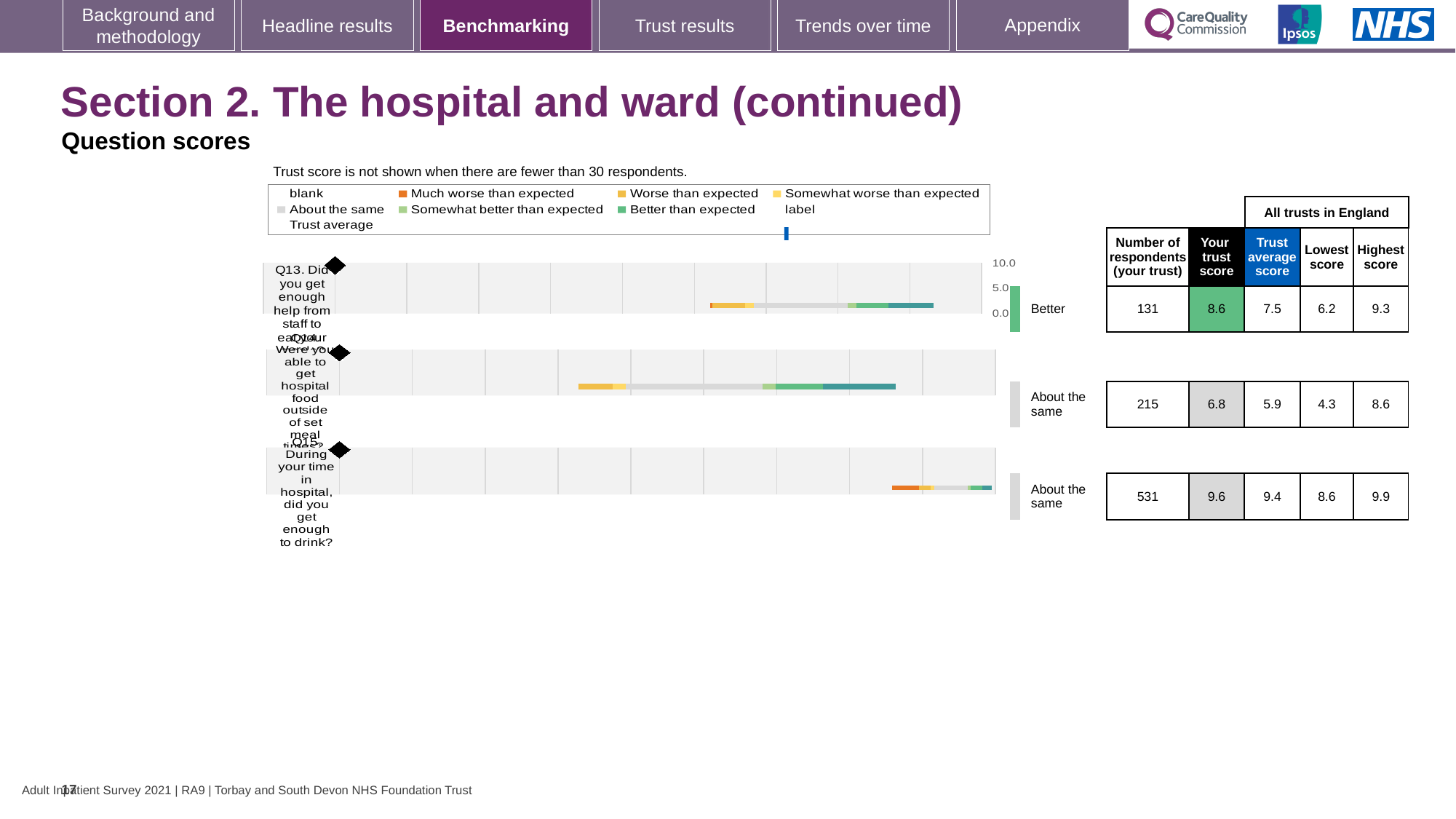
Which question has the lowest 'Your trust score'? Q14 Which question has the highest 'Your trust score'? Q15 What is the 'Your trust score' value for Q13 (help from staff to eat meals)? 8.6 What is the highest score across all trusts in England for Q14? 8.6 How many respondents answered Q15 for this trust? 531 What is the difference between the trust score and the trust average score for Q13? 1.1 What benchmark category is shown for Q13? Better What is the 'Your trust score' value for Q15 (enough to drink)? 9.6 What kind of chart is used to show the question scores on this slide? bar chart How many questions (rows) are plotted in the chart? 3 What is the 'Your trust score' value for Q14 (hospital food outside of set meal times)? 6.8 Which has the larger 'Your trust score', Q13 or Q14? Q13